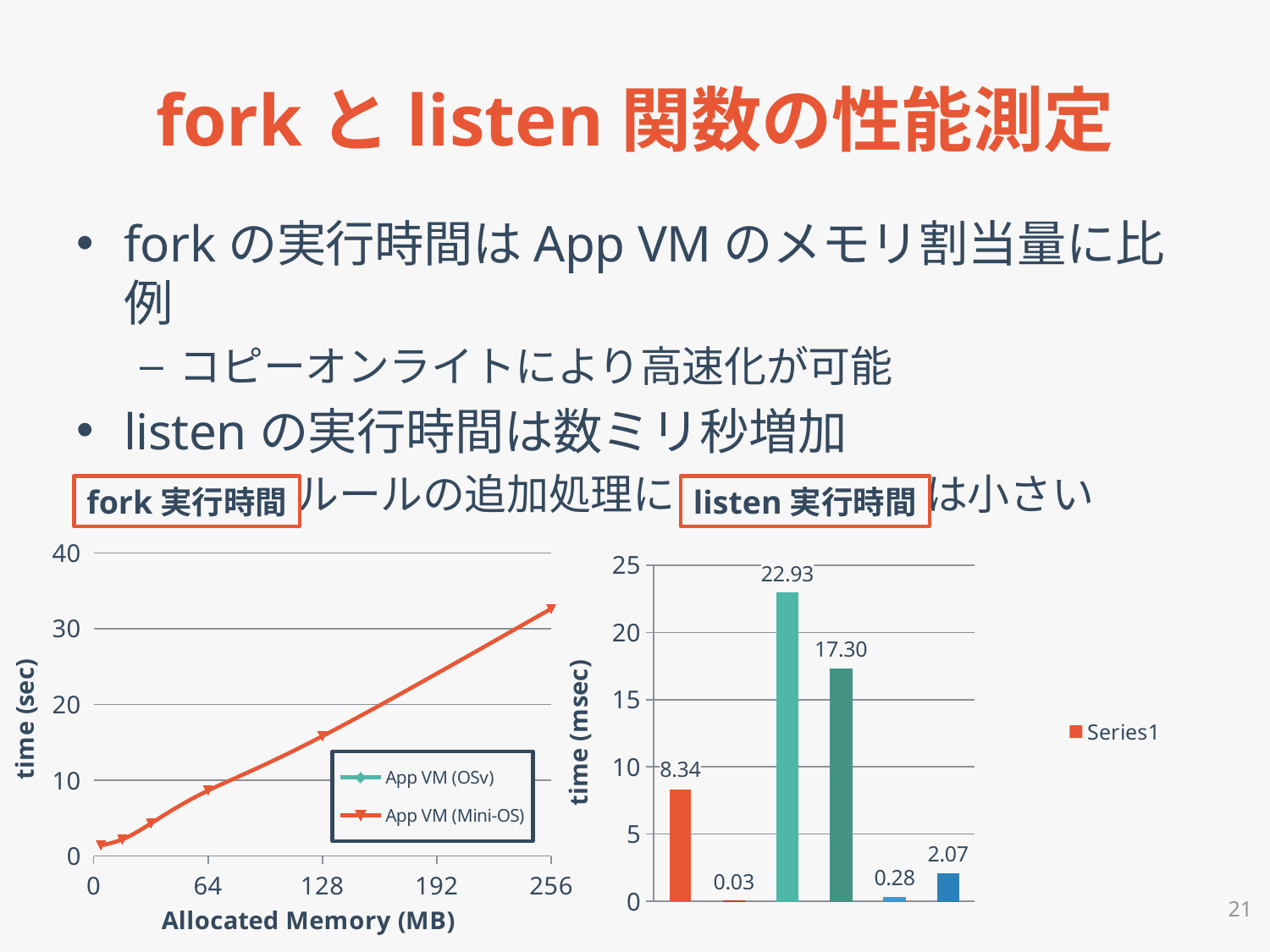
In the 'listen 実行時間' chart, what is the value of the first (leftmost) bar? 8.34 What kind of chart is the 'listen 実行時間' chart on the right? bar chart In the 'listen 実行時間' chart, what is the difference between the two tallest bars, 22.93 and 17.30? 5.63 In the 'listen 実行時間' chart, what is the label of the y axis? time (msec) In the 'fork 実行時間' chart, does the App VM (Mini-OS) execution time rise or fall as allocated memory increases? rise In the 'listen 実行時間' chart, what is the value of the smallest bar? 0.03 In the 'listen 実行時間' chart, what is the value of the last (rightmost) bar? 2.07 What kind of chart is the 'fork 実行時間' chart on the left? line chart In the 'listen 実行時間' chart, what is the value of the tallest bar? 22.93 In the 'fork 実行時間' chart, is the value for App VM (Mini-OS) at 256 MB greater or less than 30? greater In the 'fork 実行時間' chart, is the value for App VM (Mini-OS) at 64 MB greater or less than 10? less In the 'listen 実行時間' chart, how many bars are plotted? 6